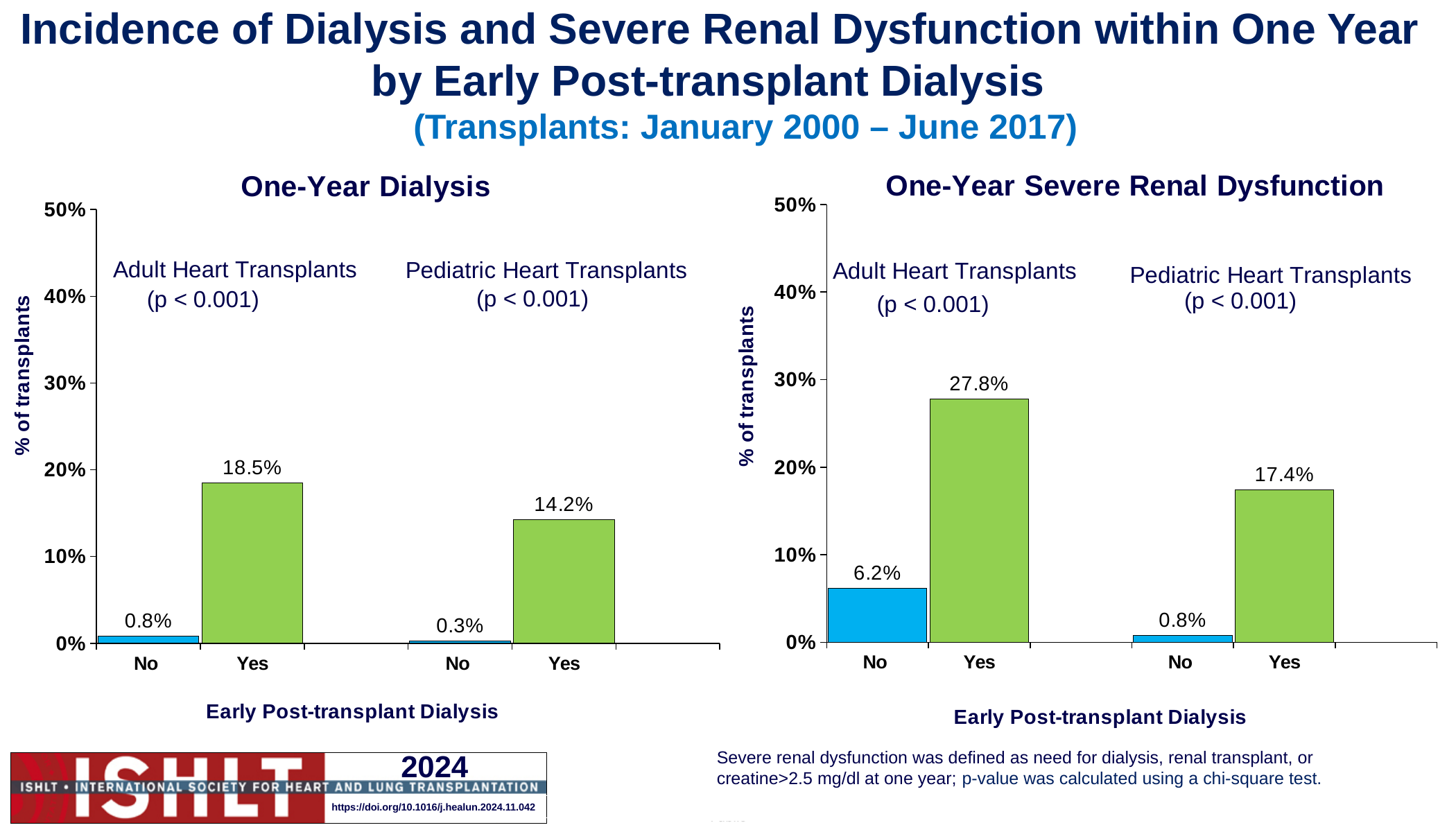
In the One-Year Dialysis chart, which is larger: the Yes bar for Adult Heart Transplants or the Yes bar for Pediatric Heart Transplants? Adult Heart Transplants In the One-Year Dialysis chart, what is the value for Pediatric Heart Transplants without early post-transplant dialysis (No)? 0.3% In the One-Year Severe Renal Dysfunction chart, is the value for Adult Heart Transplants (Yes) greater or less than 30%? less In the One-Year Severe Renal Dysfunction chart, what is the value for Pediatric Heart Transplants without early post-transplant dialysis (No)? 0.8% In the One-Year Dialysis chart, what is the difference between the Yes and No bars for Adult Heart Transplants? 17.7% What type of chart is the One-Year Severe Renal Dysfunction chart? Bar chart In the One-Year Dialysis chart, what is the value for Adult Heart Transplants with early post-transplant dialysis (Yes)? 18.5% In the One-Year Severe Renal Dysfunction chart, which bar is the highest? Adult Heart Transplants, Yes How many bars are plotted in the One-Year Dialysis chart? 4 In the One-Year Severe Renal Dysfunction chart, what is the value for Adult Heart Transplants with early post-transplant dialysis (Yes)? 27.8% In the One-Year Severe Renal Dysfunction chart, what is the difference between the Adult and Pediatric Yes bars? 10.4% In the One-Year Dialysis chart, which bar is the lowest? Pediatric Heart Transplants, No